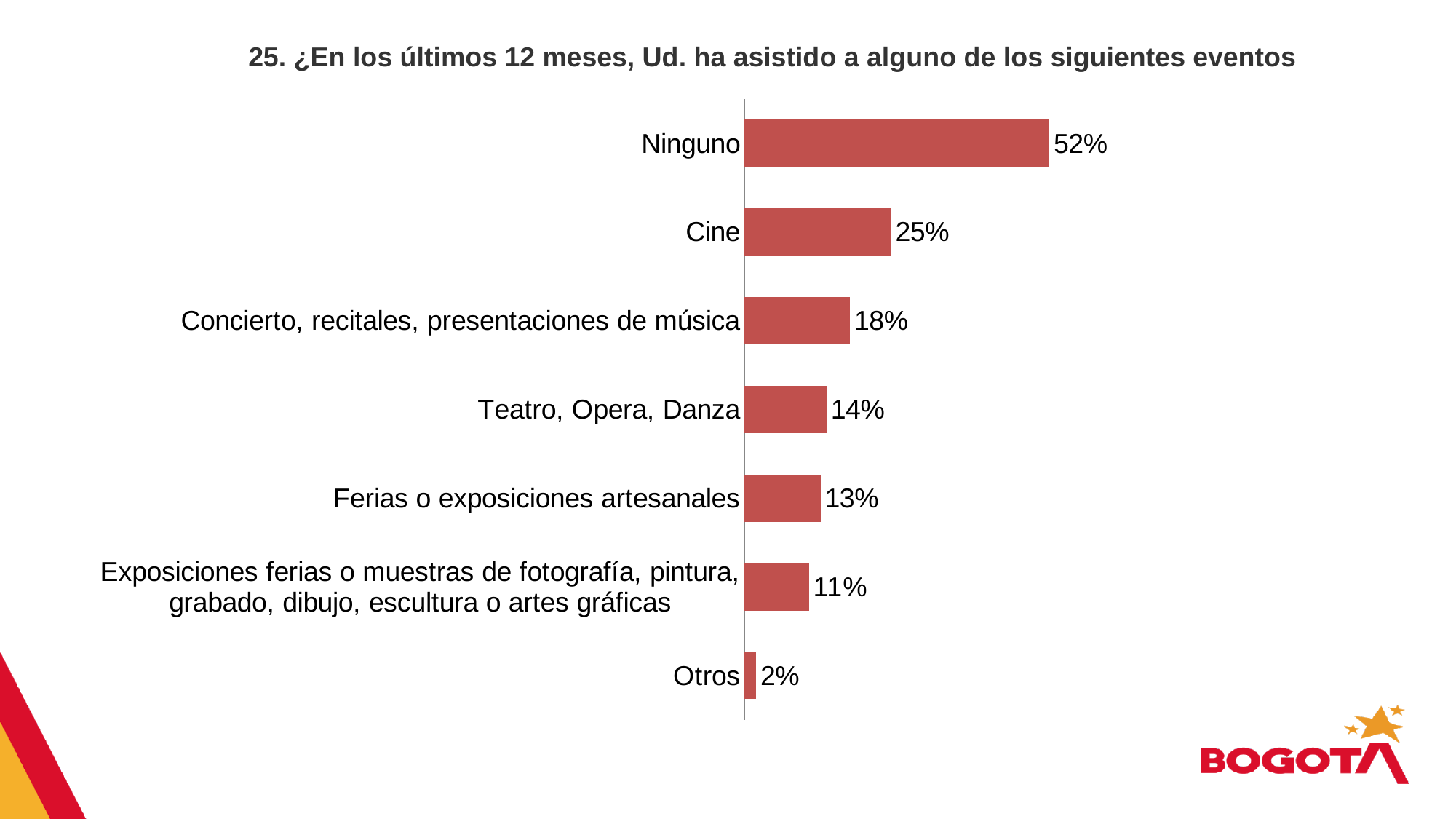
What is the value for Ferias o exposiciones artesanales? 13% What is the title of the chart? 25. ¿En los últimos 12 meses, Ud. ha asistido a alguno de los siguientes eventos How many categories are shown in the chart? 7 What is the value for Cine? 25% What is the difference between the values for Ninguno and Cine? 27% What is the value for Teatro, Opera, Danza? 14% What is the value for Ninguno? 52% Which category has the lowest value? Otros Which category has the highest value? Ninguno What is the difference between the values for Concierto, recitales, presentaciones de música and Teatro, Opera, Danza? 4% Which is larger, the value for Cine or the value for Concierto, recitales, presentaciones de música? Cine What kind of chart is shown on the slide? Bar chart